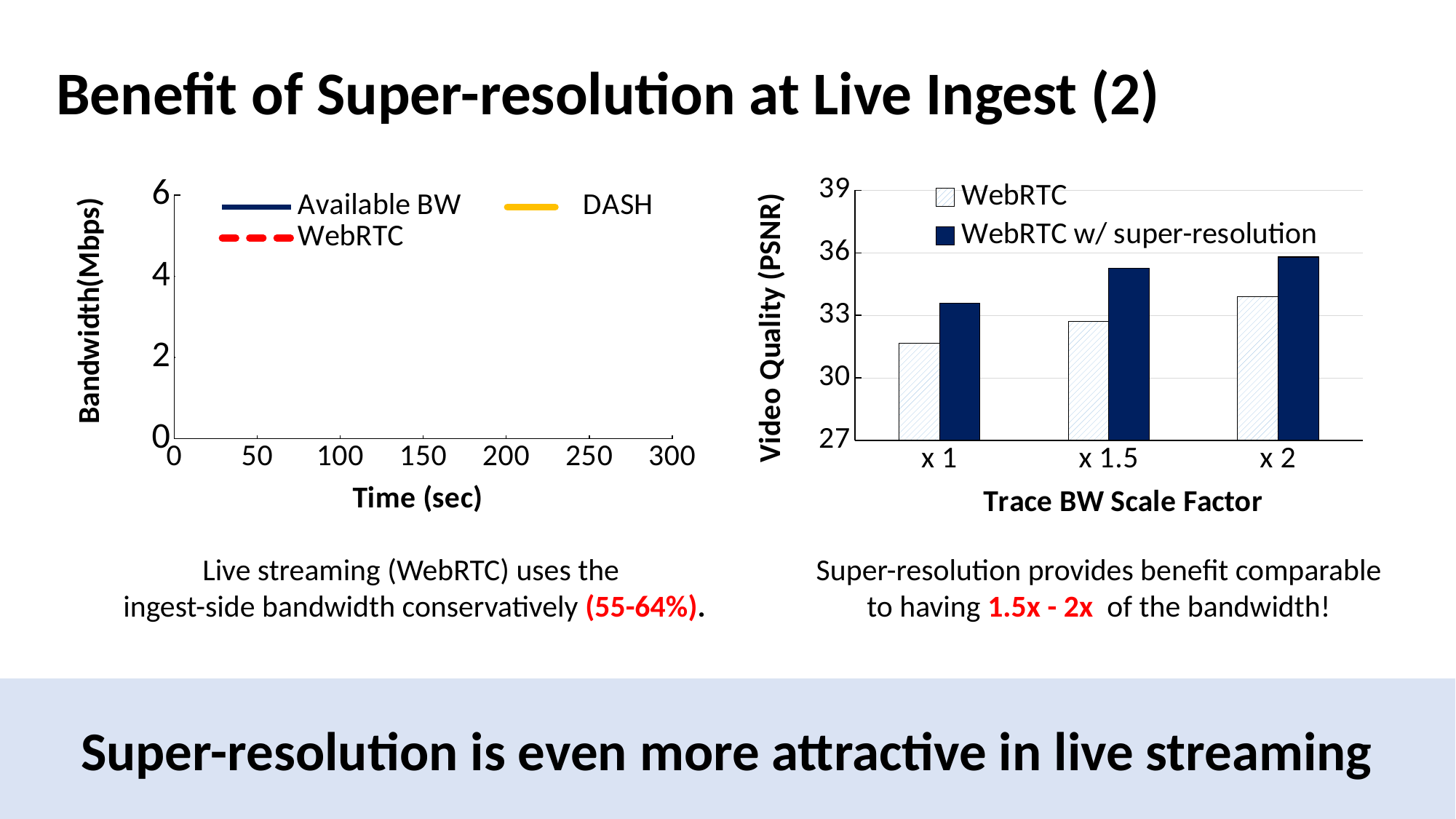
In the right-hand bar chart, is the WebRTC w/ super-resolution value at x 1.5 greater or less than 36? less In the right-hand bar chart, is the WebRTC value at x 1 greater or less than 33? less What kind of chart is the chart on the right, titled 'Video Quality (PSNR)' vs 'Trace BW Scale Factor'? bar chart In the right-hand bar chart, how many series does the legend list? 2 In the right-hand bar chart, at x 1.5, which is larger: WebRTC or WebRTC w/ super-resolution? WebRTC w/ super-resolution In the right-hand bar chart, do the WebRTC values rise or fall as the Trace BW Scale Factor increases from x 1 to x 2? rise In the left-hand chart, how many series does the legend list? 3 In the right-hand bar chart, which bar is the lowest overall? WebRTC at x 1 What is the y-axis label of the left-hand chart? Bandwidth(Mbps) In the right-hand bar chart, how many categories are shown on the x axis? 3 In the right-hand bar chart, is the WebRTC value at x 2 greater or less than 33? greater In the right-hand bar chart, which category has the highest bar for WebRTC w/ super-resolution? x 2